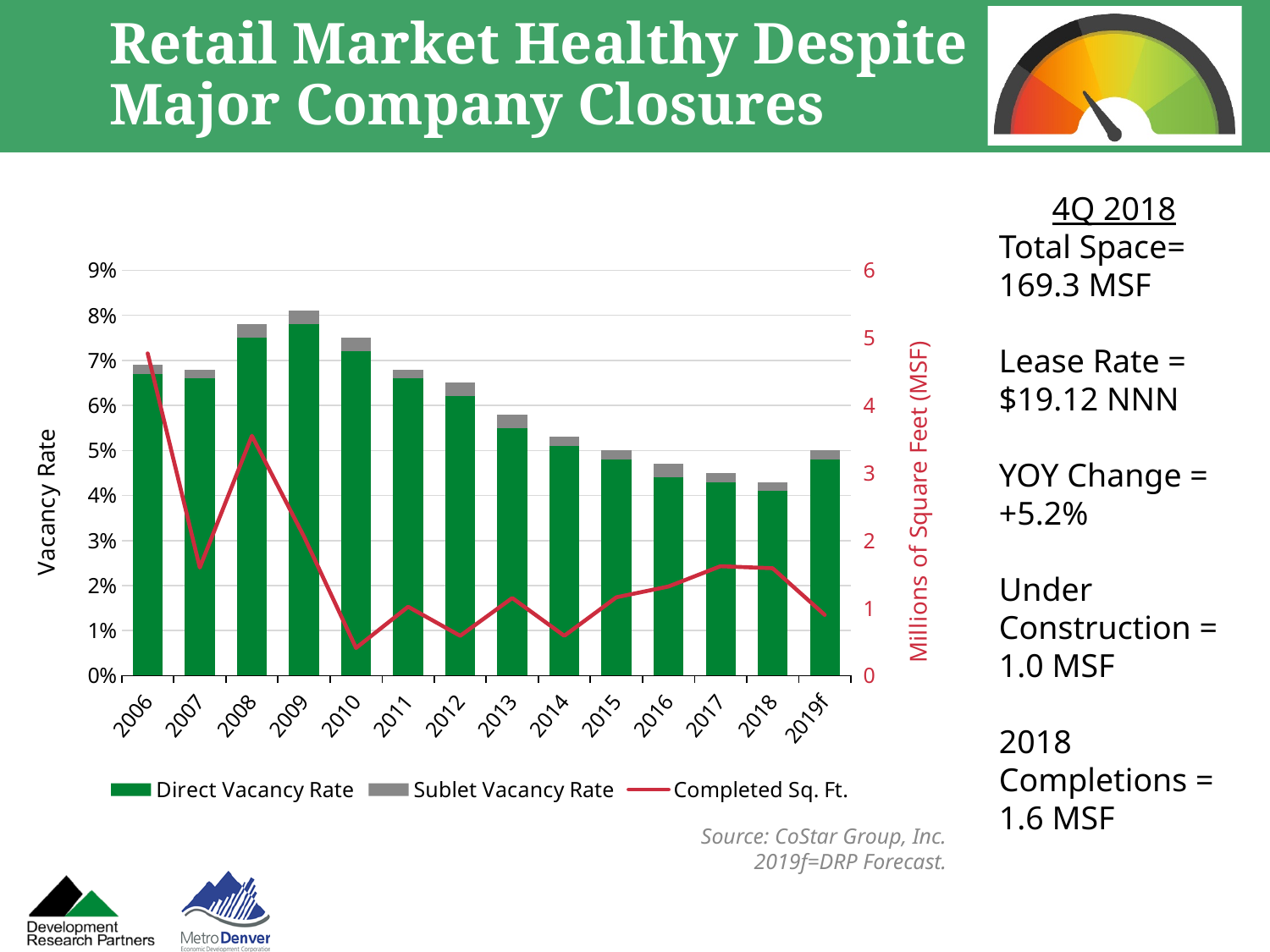
In which year is the Completed Sq. Ft. line at its lowest? 2010 Which year has the lowest total vacancy rate (direct plus sublet) in the chart? 2018 How many years are shown on the x axis of the chart? 14 Which year has the highest total vacancy rate (direct plus sublet) in the chart? 2009 Which year has the larger Direct Vacancy Rate, 2012 or 2016? 2012 Is the Completed Sq. Ft. value for 2010 greater or less than 1 MSF? less Which year has the larger Completed Sq. Ft. value, 2014 or 2017? 2017 Is the Direct Vacancy Rate for 2009 greater or less than 7%? greater In which year is the Completed Sq. Ft. line at its highest? 2006 Is the Completed Sq. Ft. value for 2006 greater or less than 4 MSF? greater How many series does the chart legend list? 3